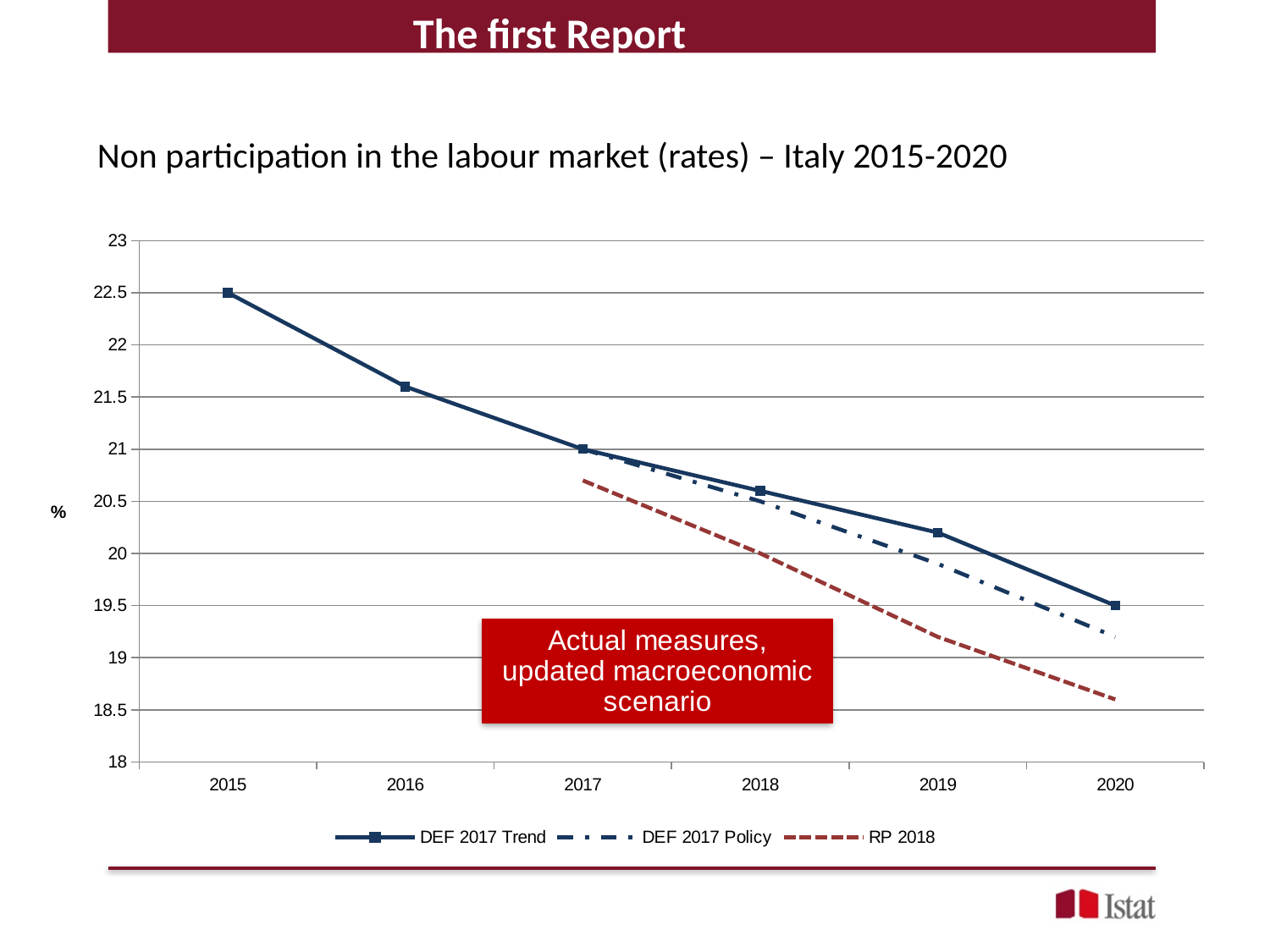
How many series does the legend list? 3 Do the DEF 2017 Trend values rise or fall from 2015 to 2020? fall What label is shown on the y axis? % In which year is DEF 2017 Trend highest? 2015 How many years are shown on the x axis? 6 What is the value of DEF 2017 Trend in 2017? 21 In 2020, which series is higher: DEF 2017 Trend or RP 2018? DEF 2017 Trend By how much does DEF 2017 Trend fall from 2015 to 2020? 3 What is the value of DEF 2017 Trend in 2015? 22.5 What kind of chart is shown on the slide? line chart Is the value for RP 2018 in 2020 greater or less than 19? less What is the value of DEF 2017 Trend in 2020? 19.5